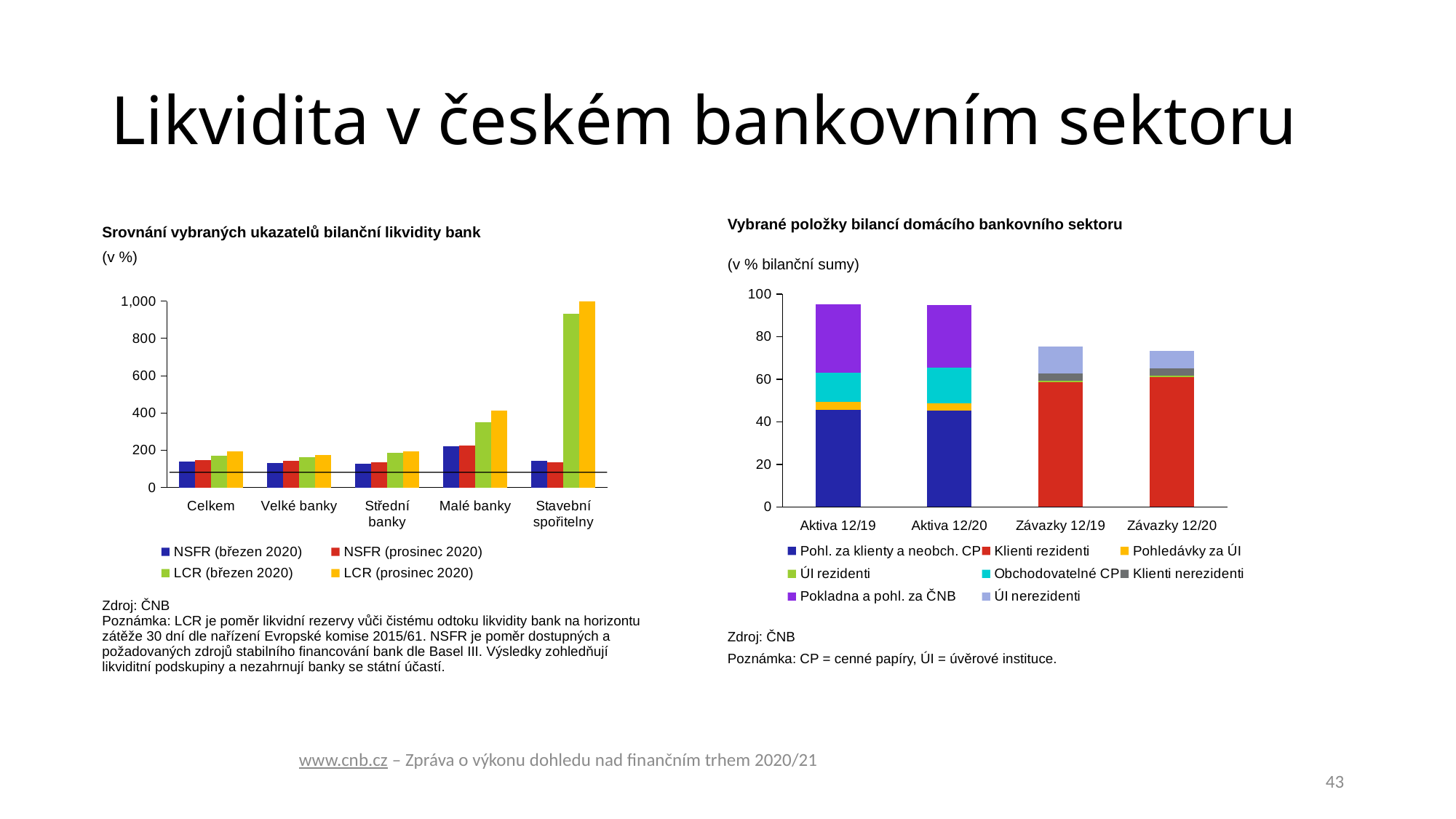
How many series does the legend of the right chart, 'Vybrané položky bilancí domácího bankovního sektoru', list? 8 In the right chart, 'Vybrané položky bilancí domácího bankovního sektoru', which bar is taller in total: Aktiva 12/20 or Závazky 12/20? Aktiva 12/20 In the right chart, 'Vybrané položky bilancí domácího bankovního sektoru', is the total height of the Aktiva 12/19 bar greater or less than 80? greater What kind of chart is the left chart, 'Srovnání vybraných ukazatelů bilanční likvidity bank'? bar chart In the left chart, 'Srovnání vybraných ukazatelů bilanční likvidity bank', which category has the highest value for LCR (prosinec 2020)? Stavební spořitelny How many bars are shown in the right chart, 'Vybrané položky bilancí domácího bankovního sektoru'? 4 What kind of chart is the right chart, 'Vybrané položky bilancí domácího bankovního sektoru'? stacked bar chart In the left chart, 'Srovnání vybraných ukazatelů bilanční likvidity bank', which is larger: LCR (prosinec 2020) for Malé banky or LCR (prosinec 2020) for Velké banky? Malé banky In the left chart, 'Srovnání vybraných ukazatelů bilanční likvidity bank', is the value of LCR (prosinec 2020) for Stavební spořitelny greater or less than 800? greater How many categories are shown on the x axis of the left chart, 'Srovnání vybraných ukazatelů bilanční likvidity bank'? 5 How many series does the legend of the left chart, 'Srovnání vybraných ukazatelů bilanční likvidity bank', list? 4 In the left chart, 'Srovnání vybraných ukazatelů bilanční likvidity bank', is the value of NSFR (březen 2020) for Celkem greater or less than 200? less